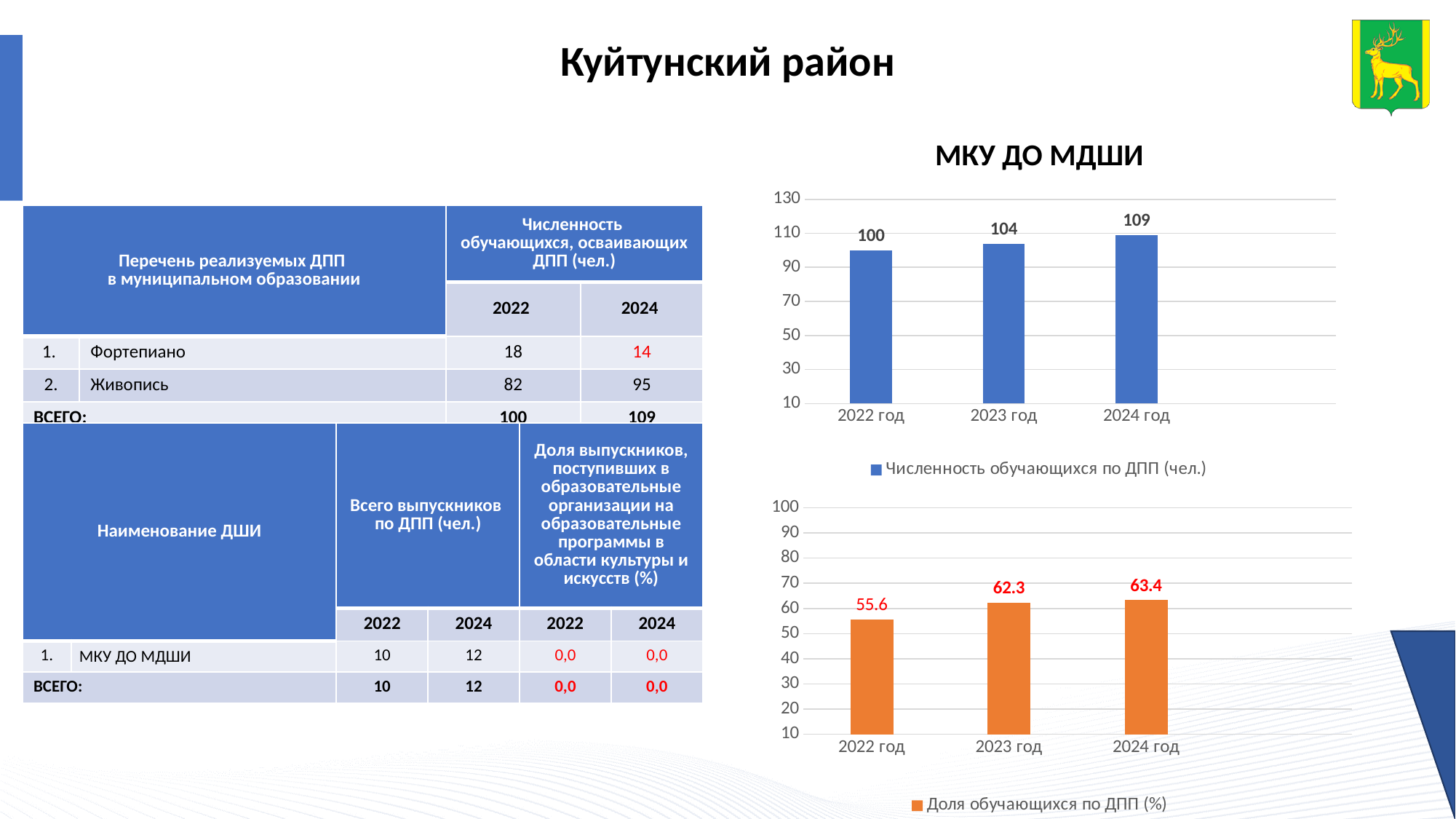
What kind of chart is the bottom chart on the slide? bar chart In the bottom chart on the slide, what is the value for 2024 год? 63.4 What series name does the legend of the bottom chart on the slide show? Доля обучающихся по ДПП (%) In the top chart titled МКУ ДО МДШИ, how many bars are plotted? 3 In the bottom chart on the slide, what is the difference between the values for 2023 год and 2022 год? 6.7 In the bottom chart on the slide, what is the value for 2022 год? 55.6 In the top chart titled МКУ ДО МДШИ, which year has the lowest value? 2022 год In the bottom chart on the slide, which is larger, the value for 2023 год or the value for 2022 год? 2023 год In the top chart titled МКУ ДО МДШИ, what is the difference between the values for 2024 год and 2022 год? 9 In the top chart titled МКУ ДО МДШИ, which year has the highest value? 2024 год In the top chart titled МКУ ДО МДШИ, do the values rise or fall from 2022 год to 2024 год? rise In the top chart titled МКУ ДО МДШИ, what is the value for 2023 год? 104